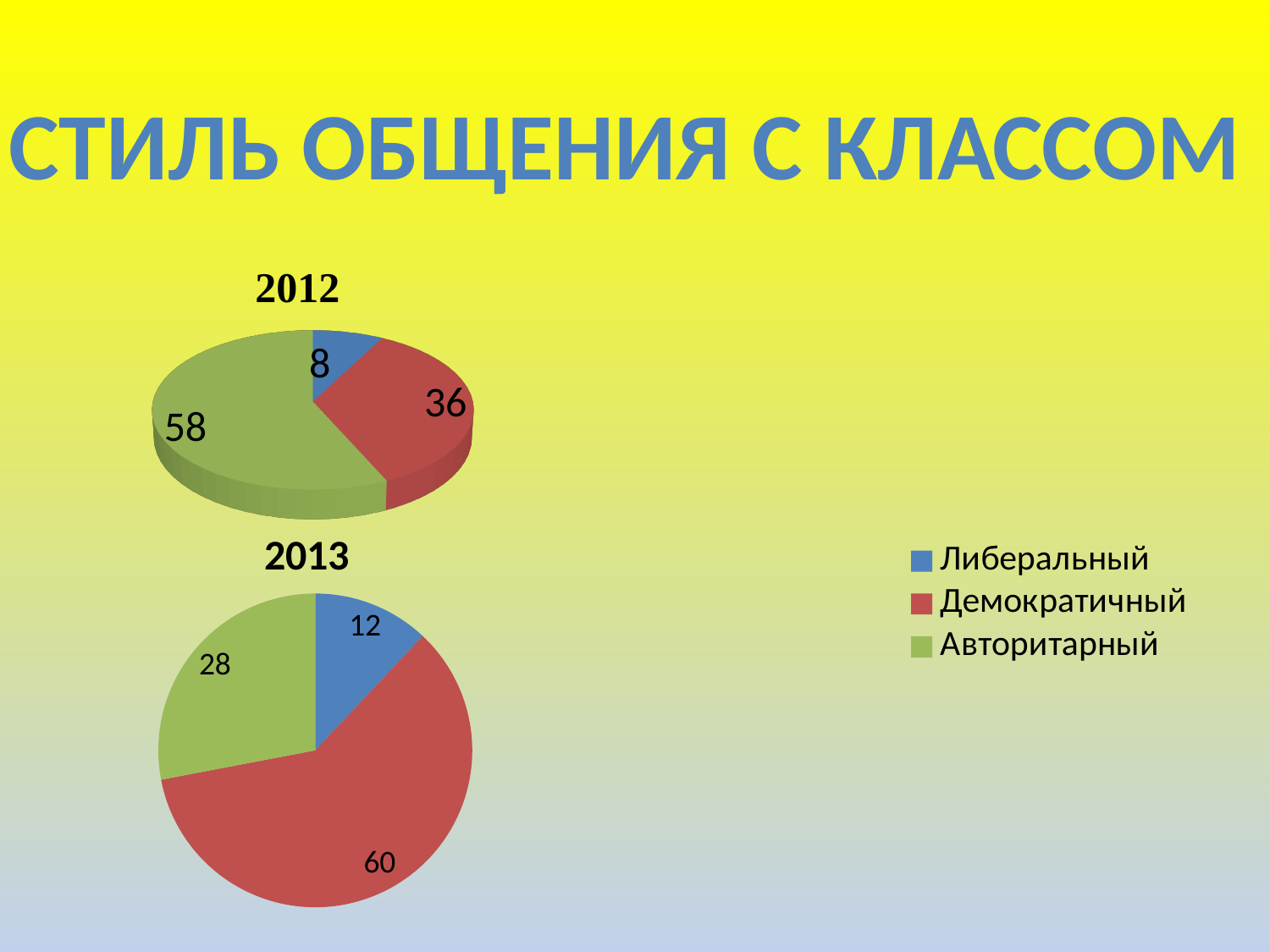
In the 2013 chart, what is the difference between the values for Демократичный and Авторитарный? 32 In the 2012 chart, which category has the largest slice? Авторитарный In the 2012 chart, which category has the smallest slice? Либеральный In the 2013 chart, what is the value for Авторитарный? 28 How many entries does the legend list? 3 What type of chart is the 2012 chart? pie chart In the 2012 chart, what is the value for Либеральный? 8 How many slices does the 2013 chart have? 3 Which is larger: the value for Либеральный in 2012 or in 2013? 2013 In the 2013 chart, which category has the largest slice? Демократичный In the 2012 chart, what is the value for Демократичный? 36 What colour represents Авторитарный in the legend? green